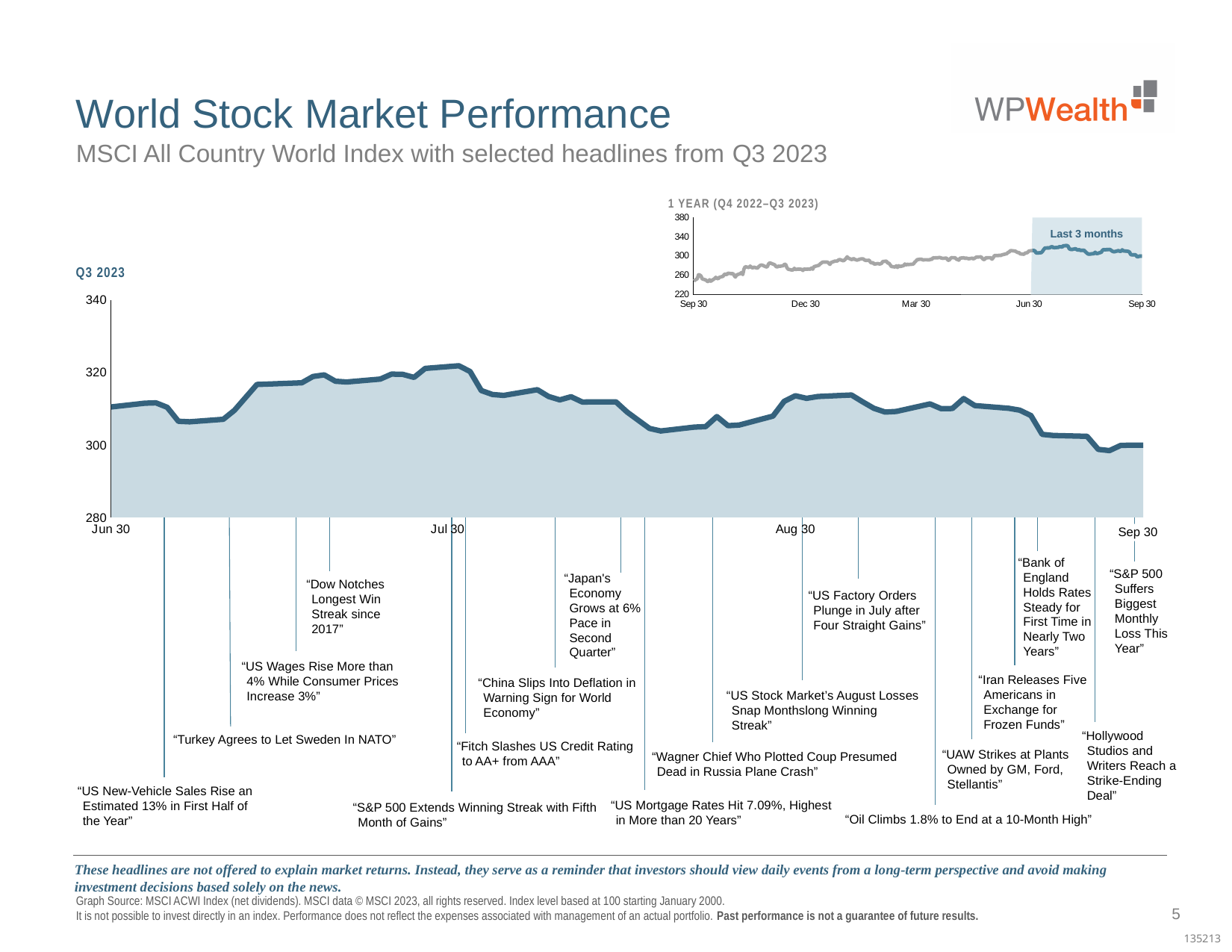
On the Q3 2023 chart, is the index value at Aug 30 greater or less than 300? greater On the 1 YEAR (Q4 2022–Q3 2023) chart, how many date labels are shown on the x axis? 5 On the Q3 2023 chart, does the index end the quarter (Sep 30) higher or lower than it started (Jun 30)? lower On the Q3 2023 chart, is the index value at Sep 30 greater or less than 320? less What is the title of the small inset chart at the top right of the slide? 1 YEAR (Q4 2022–Q3 2023) What kind of chart is the large Q3 2023 chart? area chart On the Q3 2023 chart, is the index value at Jun 30 greater or less than 300? greater On the Q3 2023 chart, how many date labels are shown on the x axis? 4 On the 1 YEAR (Q4 2022–Q3 2023) chart, does the index generally rise or fall from Sep 30 to the following Sep 30? rise What label is given to the shaded region on the 1 YEAR (Q4 2022–Q3 2023) chart? Last 3 months